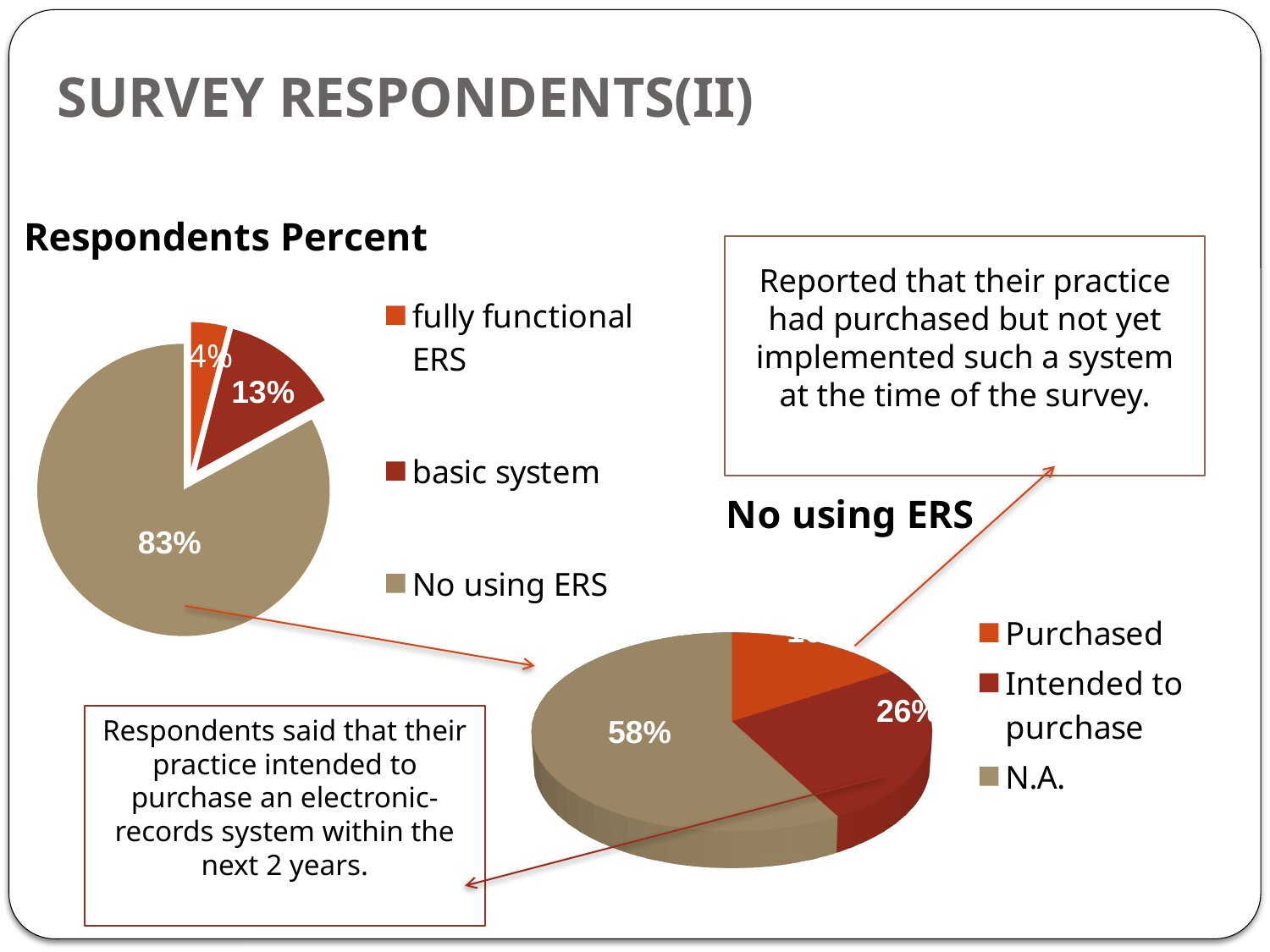
In the 'Respondents Percent' pie chart, what is the difference in percentage points between 'No using ERS' and 'basic system'? 70 In the 'No using ERS' pie chart, what percentage is labelled 'N.A.'? 58% In the 'Respondents Percent' pie chart, what percentage of respondents have a basic system? 13% In the 'Respondents Percent' pie chart, which category has the largest share? No using ERS In the 'Respondents Percent' pie chart, what percentage of respondents have a fully functional ERS? 4% In the 'Respondents Percent' pie chart, how many categories does the legend list? 3 What type of chart is the 'No using ERS' chart? Pie chart In the 'Respondents Percent' pie chart, which category has the smallest share? fully functional ERS In the 'Respondents Percent' pie chart, what percentage of respondents are not using ERS? 83% In the 'No using ERS' pie chart, what percentage is labelled 'Intended to purchase'? 26% In the 'No using ERS' pie chart, which category has the largest share? N.A. In the 'No using ERS' pie chart, which is larger: 'Intended to purchase' or 'N.A.'? N.A.